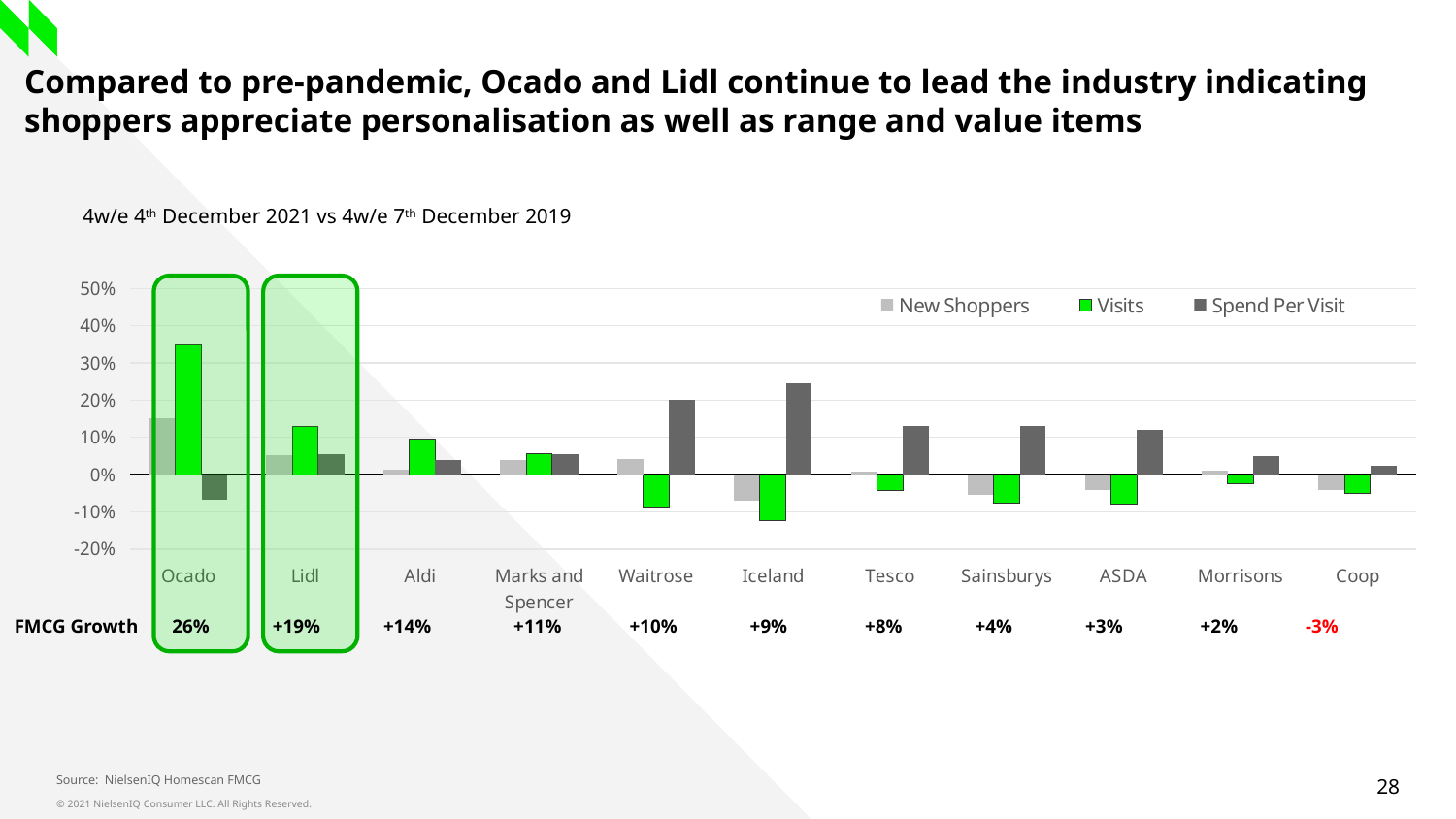
How many retailers are shown on the x axis of the chart? 11 Which is larger, the Visits value for Ocado or the Visits value for Lidl? Ocado Which two retailers are highlighted with green boxes on the chart? Ocado and Lidl Is the Spend Per Visit value for Iceland greater or less than 20%? greater Is the Visits value for Iceland greater or less than -10%? less Which retailer has the highest Visits value? Ocado How many series does the legend list? 3 Which retailer has the highest Spend Per Visit value? Iceland What kind of chart is shown on the slide? bar chart Is the Visits value for Ocado greater or less than 30%? greater What FMCG Growth figure is shown for Coop below the chart? -3% Which retailer has the lowest Visits value? Iceland